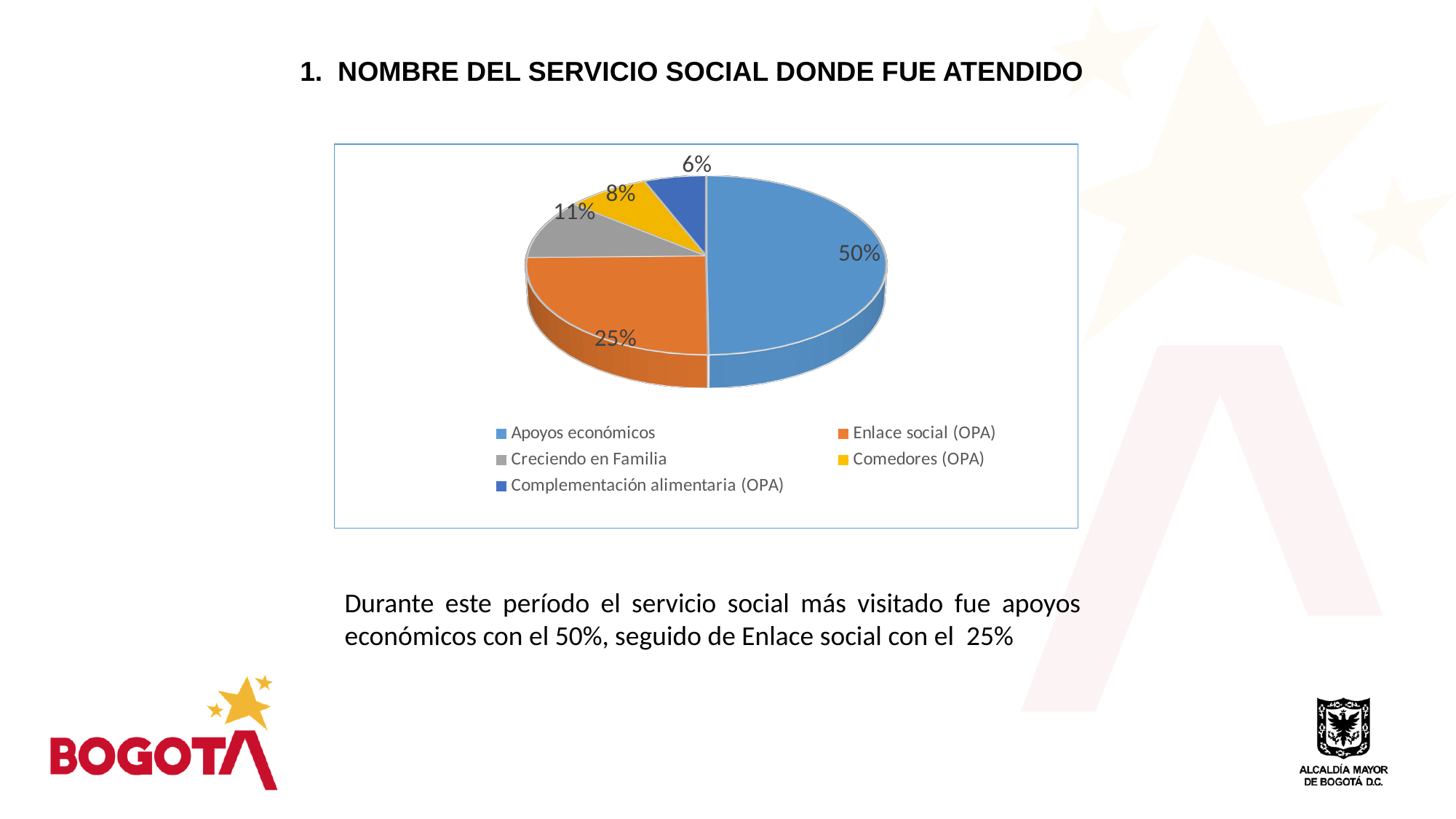
How many categories does the pie chart show? 5 What kind of chart is shown on the slide? Pie chart What colour is the slice for Comedores (OPA)? Yellow Which category has the smallest slice of the pie? Complementación alimentaria (OPA) What share of the pie does Comedores (OPA) have? 8% What share of the pie does Enlace social (OPA) have? 25% Which category has the largest slice of the pie? Apoyos económicos What share of the pie does Complementación alimentaria (OPA) have? 6% What is the difference in percentage points between Apoyos económicos and Enlace social (OPA)? 25 Which is larger, the share for Creciendo en Familia or the share for Comedores (OPA)? Creciendo en Familia